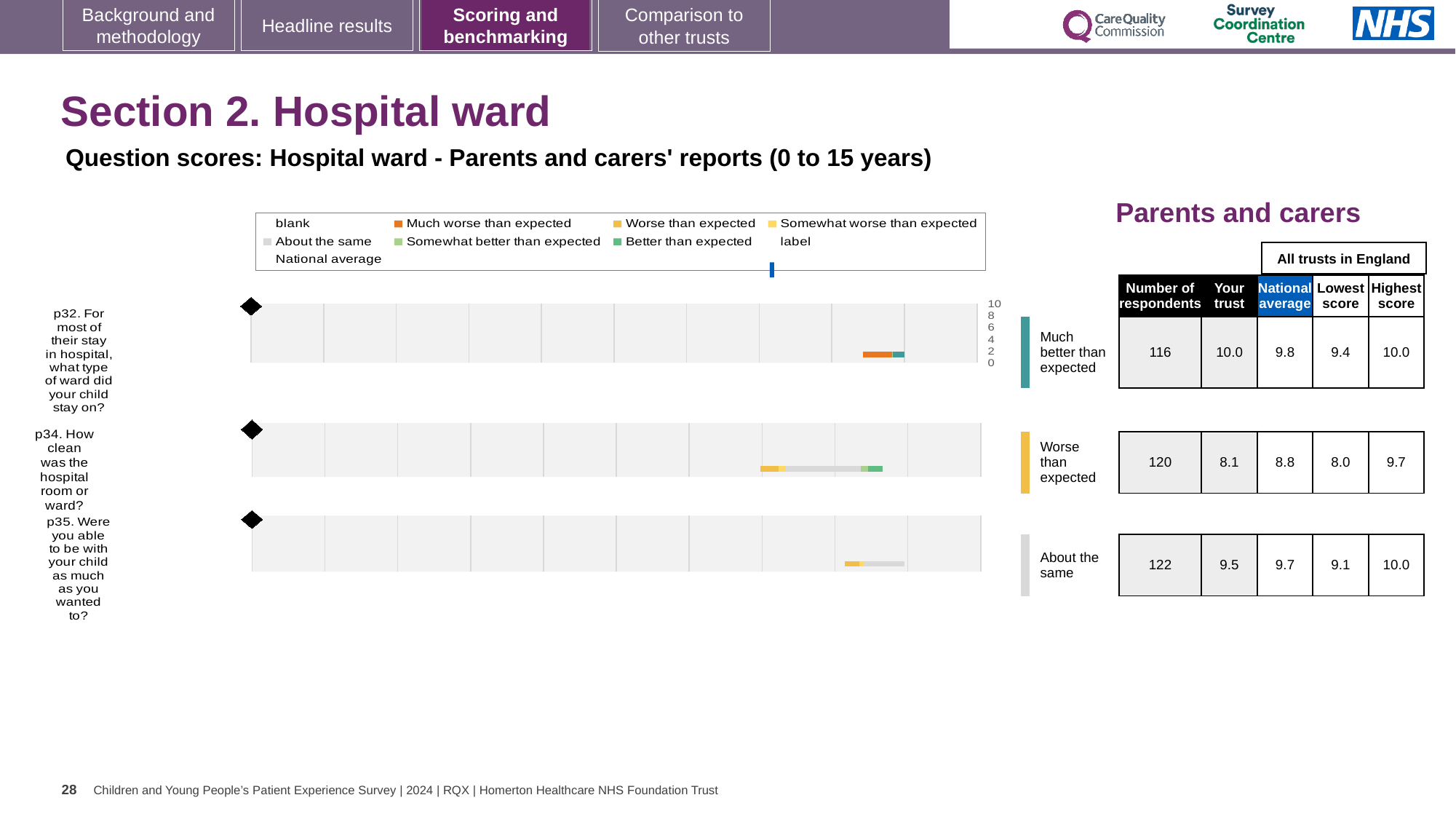
In the table next to the chart, what is the 'Your trust' score for p34 (How clean was the hospital room or ward)? 8.1 How many questions (categories) are plotted in the chart? 3 Which question has the highest 'Your trust' score in the table next to the chart? p32 In the table next to the chart, what is the highest score for p34? 9.7 What kind of chart is used to show the question scores for the hospital ward? bar chart Which question has the lowest 'Your trust' score in the table next to the chart? p34 In the table next to the chart, what is the lowest score for p32? 9.4 For p34, how much higher is the national average than the 'Your trust' score in the table next to the chart? 0.7 Which question in the chart is rated 'Much better than expected'? p32. For most of their stay in hospital, what type of ward did your child stay on? In the table next to the chart, what is the national average for p35 (Were you able to be with your child as much as you wanted to)? 9.7 In the table next to the chart, what is the number of respondents for p32? 116 Which question in the chart is rated 'Worse than expected'? p34. How clean was the hospital room or ward?